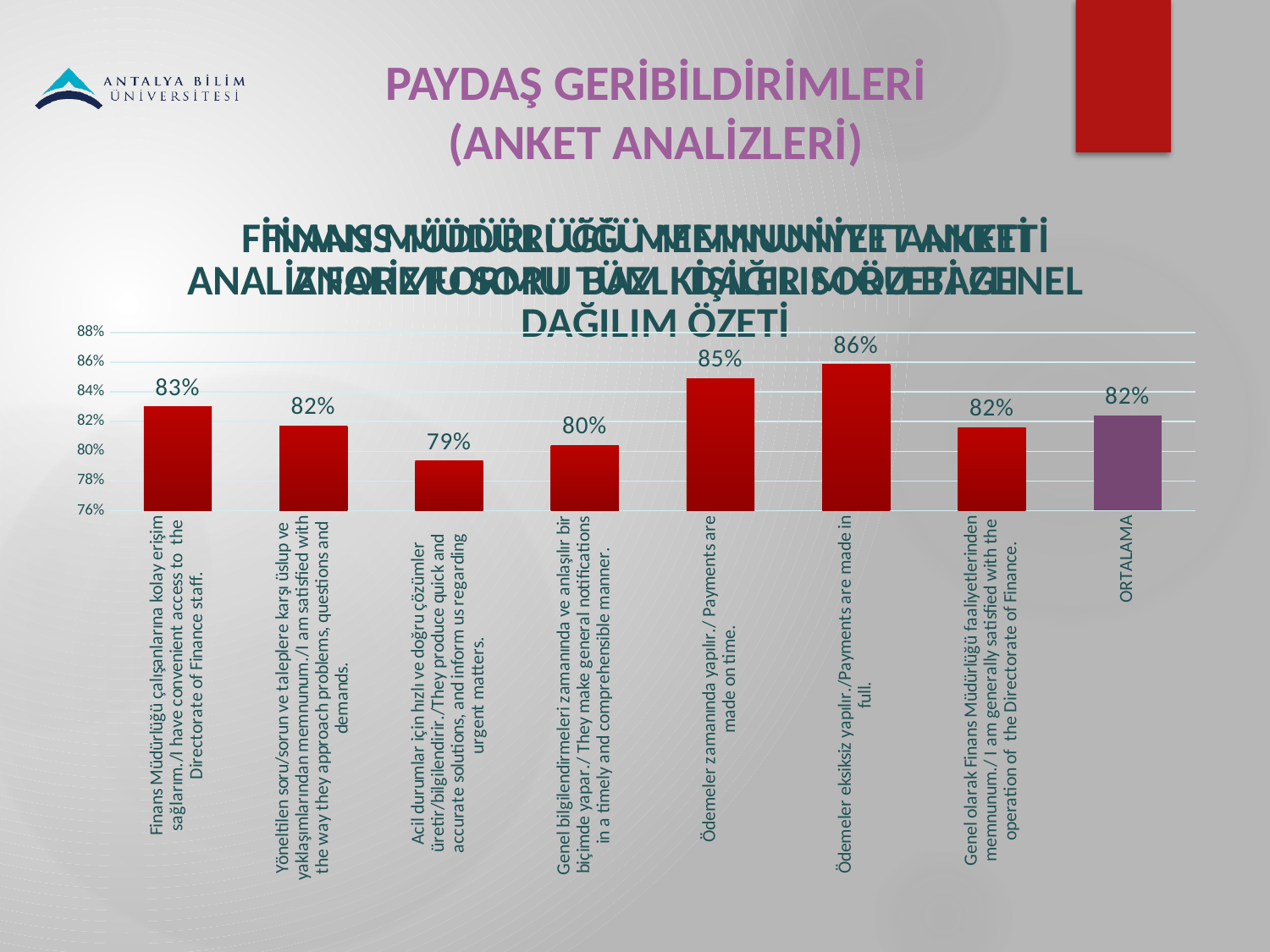
What is the value for the category about having convenient access to the Directorate of Finance staff? 83% What is the value for ORTALAMA? 82% Which bar is shown in a different colour (purple) from the others? ORTALAMA Which is larger: the value for 'Payments are made on time' or the value for 'They make general notifications in a timely and comprehensible manner'? Payments are made on time What is the value for the category 'Ödemeler zamanında yapılır./Payments are made on time.'? 85% How many bars are shown in the chart? 8 What is the difference between the value for 'Payments are made in full' and the value for 'They produce quick and accurate solutions, and inform us regarding urgent matters'? 7% Is the value for 'They make general notifications in a timely and comprehensible manner' greater or less than 82%? less Which category has the lowest value? Acil durumlar için hızlı ve doğru çözümler üretir/bilgilendirir./They produce quick and accurate solutions, and inform us regarding urgent matters. Which category has the highest value? Ödemeler eksiksiz yapılır./Payments are made in full. What kind of chart is shown on the slide? bar chart What is the value for the category 'Ödemeler eksiksiz yapılır./Payments are made in full.'? 86%